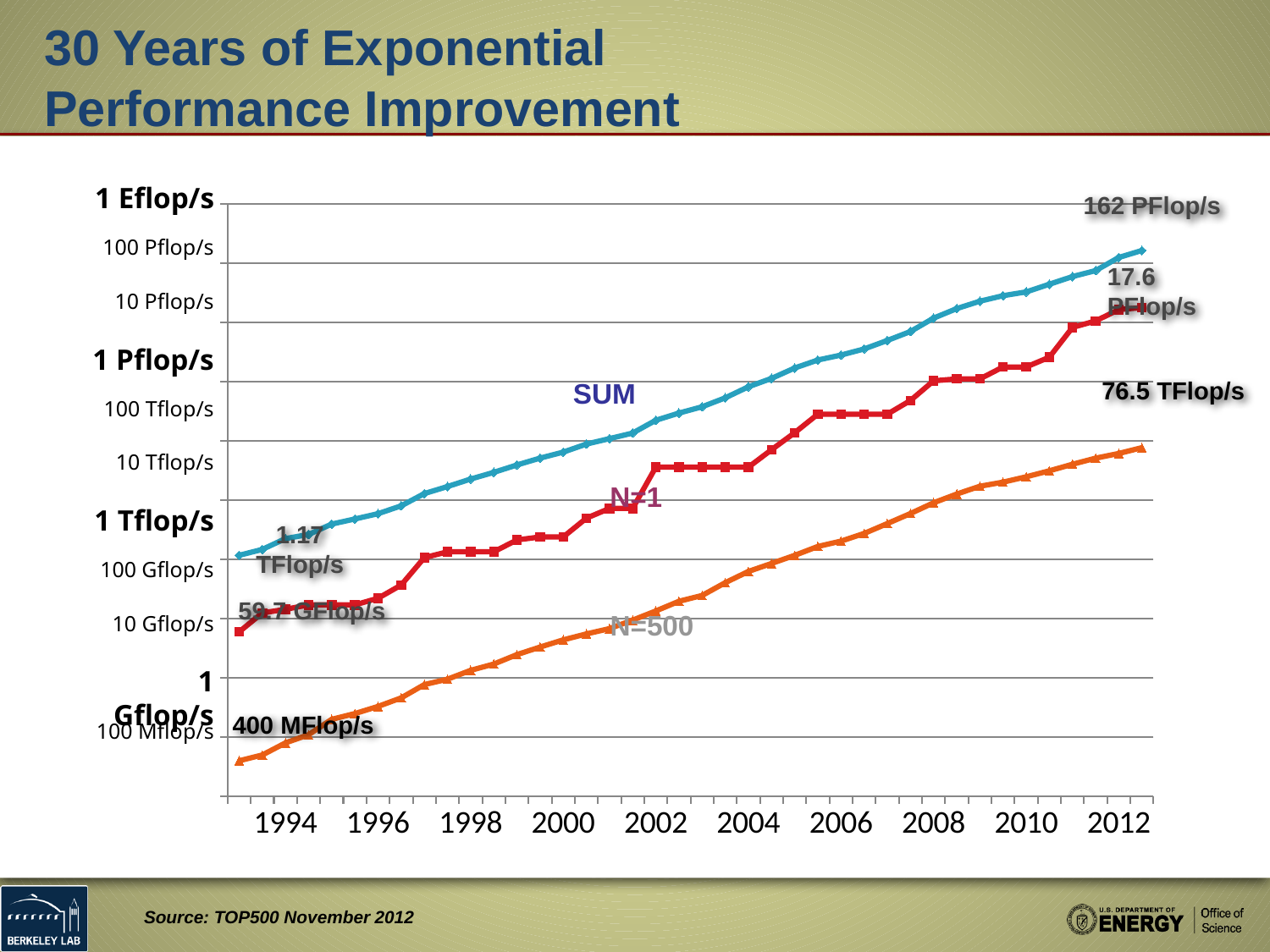
Is the value of the SUM series in 2008 greater or less than 1 Pflop/s? greater What is the labelled value of the N=1 series at the right end of the chart (2012)? 17.6 PFlop/s What is the labelled starting value of the N=500 series in 1993? 400 MFlop/s How many series are plotted on the chart? 3 What is the labelled value of the SUM series at the right end of the chart (2012)? 162 PFlop/s What is the labelled starting value of the N=1 series in 1993? 59.7 GFlop/s Which series has the lowest values across the chart? N=500 Which series has the highest values across the chart? SUM What kind of chart is shown on the slide? line chart What is the labelled value of the N=500 series at the right end of the chart (2012)? 76.5 TFlop/s Do the values of the N=500 series rise or fall from 1994 to 2012? rise What is the labelled starting value of the SUM series in 1993? 1.17 TFlop/s